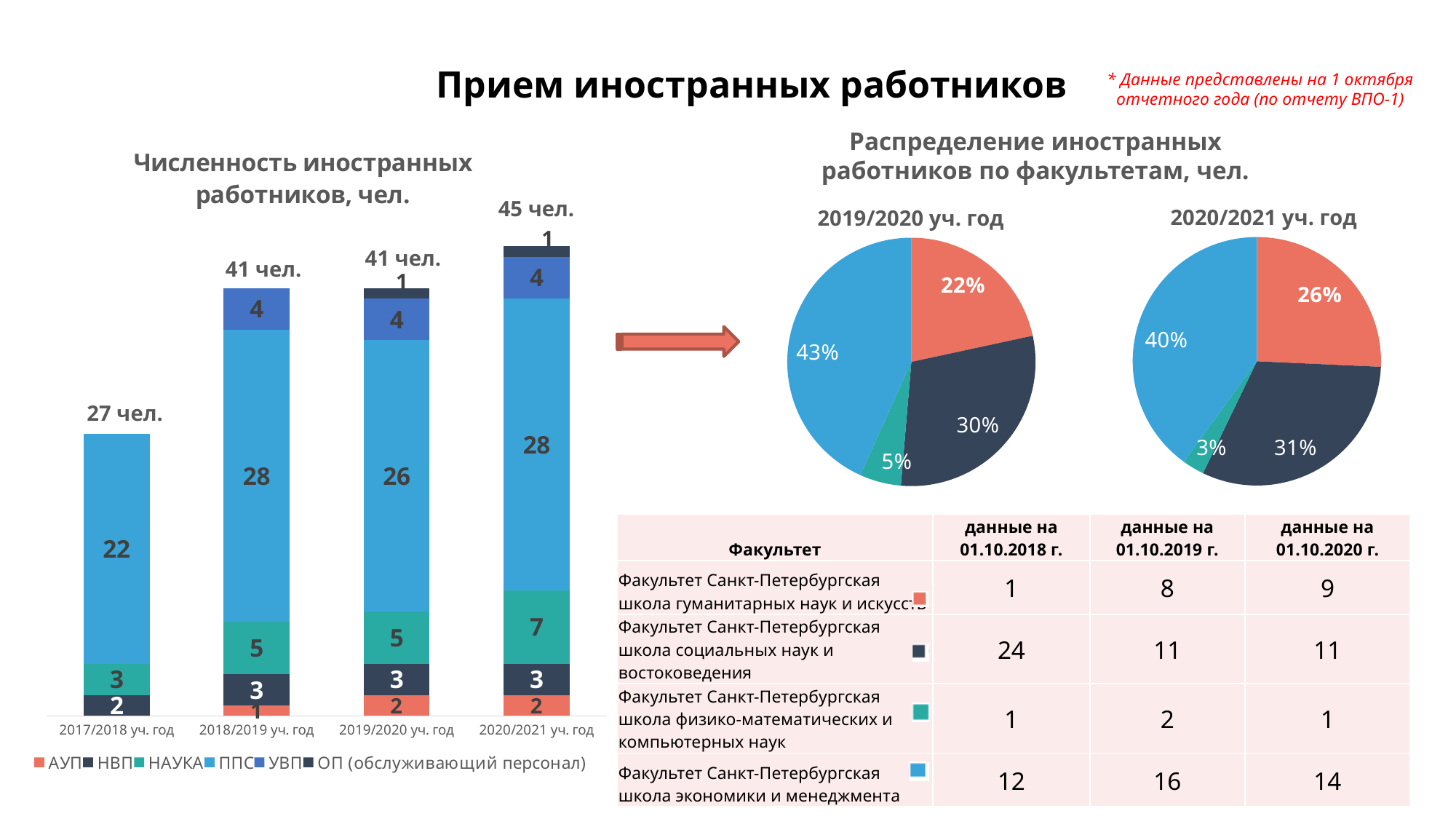
In the chart 'Численность иностранных работников, чел.', which academic year has the lowest total? 2017/2018 уч. год In the chart 'Численность иностранных работников, чел.', what is the total for 2020/2021 уч. год? 45 чел. In the chart 'Численность иностранных работников, чел.', what is the difference between the totals for 2020/2021 уч. год and 2017/2018 уч. год? 18 In the chart 'Численность иностранных работников, чел.', is the ППС value for 2019/2020 уч. год larger or smaller than for 2018/2019 уч. год? Smaller In the chart 'Численность иностранных работников, чел.', what is the ППС value for 2017/2018 уч. год? 22 In the chart 'Численность иностранных работников, чел.', what is the НАУКА value for 2020/2021 уч. год? 7 In the chart 'Численность иностранных работников, чел.', how many academic years are shown on the x axis? 4 In the pie chart for 2019/2020 уч. год, what share does the largest slice have? 43% In the chart 'Численность иностранных работников, чел.', how many series does the legend list? 6 In the pie chart for 2020/2021 уч. год, what share does the smallest slice have? 3% What kind of chart is 'Численность иностранных работников, чел.'? Stacked bar chart